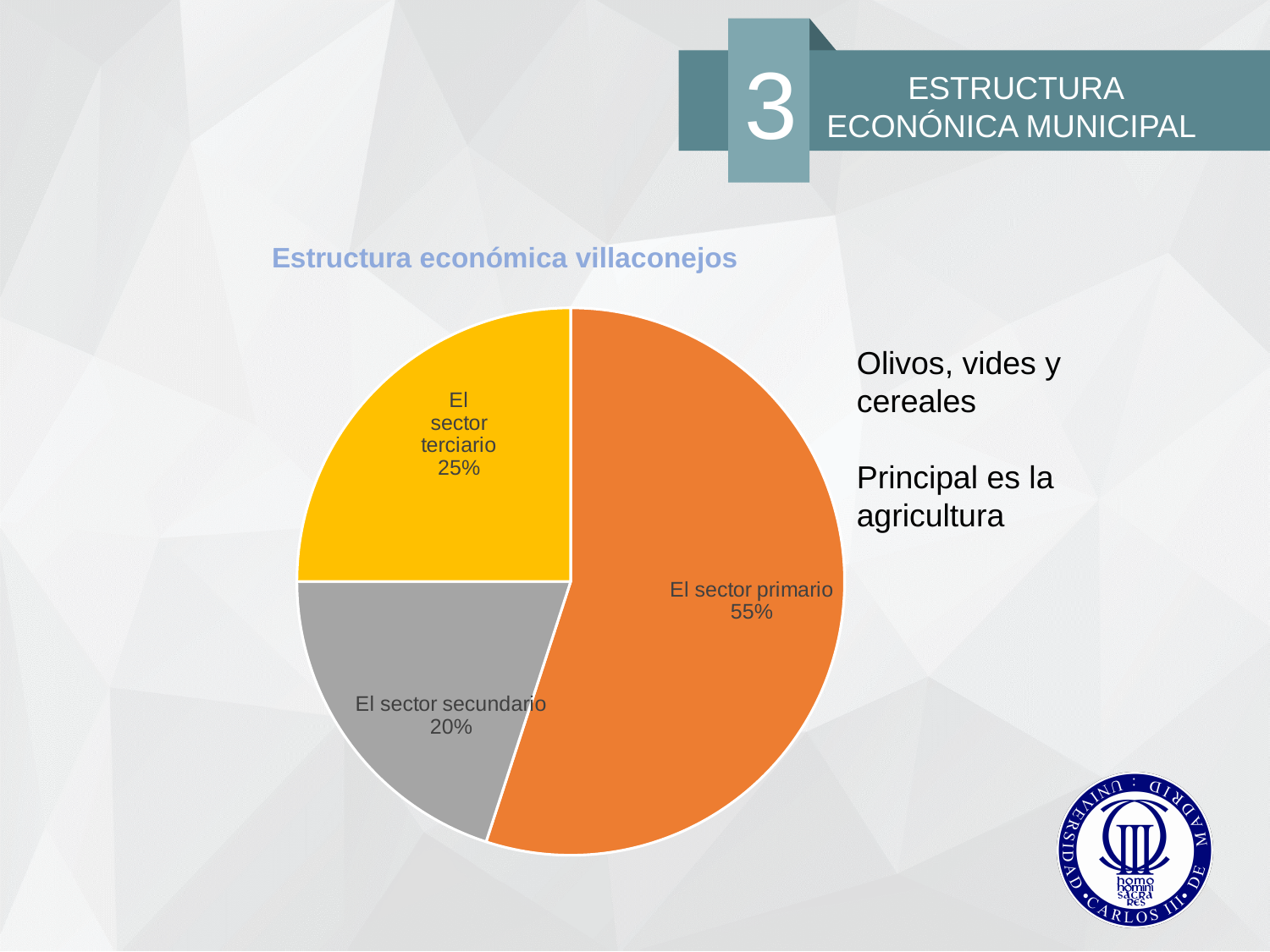
What is the difference in percentage points between El sector primario and El sector terciario? 30 Which sector has the largest slice of the pie? El sector primario What is the difference in percentage points between El sector terciario and El sector secundario? 5 What is the title of the chart? Estructura económica villaconejos How many slices does the pie chart have? 3 What share of the pie does El sector secundario have? 20% What kind of chart is shown on the slide? pie chart What colour is the slice for El sector primario? orange Which is larger, El sector terciario or El sector secundario? El sector terciario What share of the pie does El sector terciario have? 25% What share of the pie does El sector primario have? 55% Which sector has the smallest slice of the pie? El sector secundario